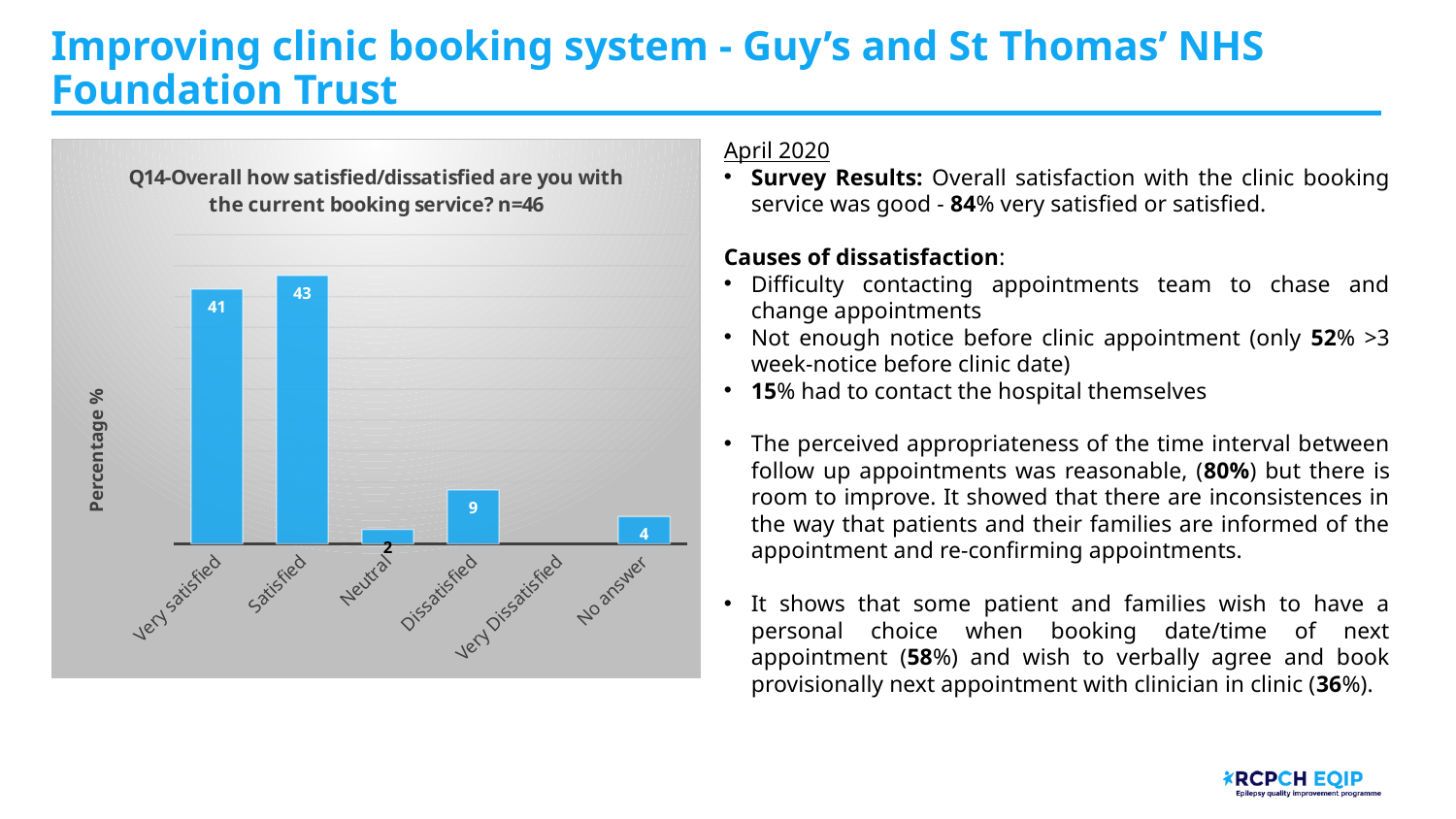
What is the value for No answer? 4 Which category has the highest value? Satisfied Which is larger, the value for Dissatisfied or the value for Neutral? Dissatisfied What kind of chart is shown? Bar chart What is the difference between the values for Satisfied and Very satisfied? 2 What is the value for Neutral? 2 What is the value for Satisfied? 43 What is the label of the y axis? Percentage % How many categories are shown on the x axis? 6 What is the value for Very satisfied? 41 What is the value for Dissatisfied? 9 What is the difference between the values for Dissatisfied and No answer? 5